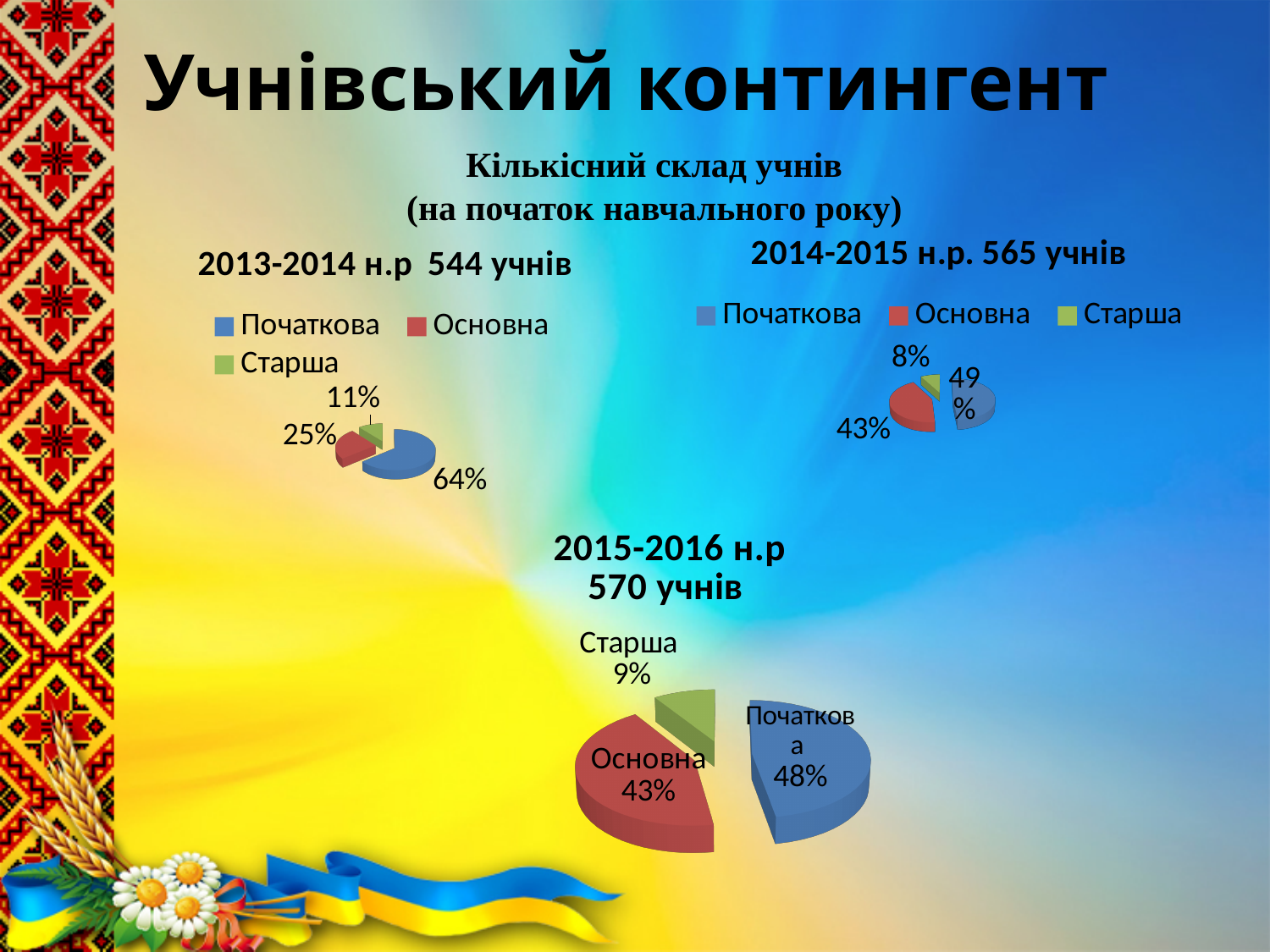
How many entries does the legend of the 2014-2015 н.р. chart list? 3 In the 2015-2016 н.р chart, what share does Основна have? 43% In the 2013-2014 н.р chart, which category has the smallest slice? Старша In the 2013-2014 н.р chart, what share does Початкова have? 64% In the 2013-2014 н.р chart, what is the difference between the Початкова and Основна shares? 39% In the 2015-2016 н.р chart, which category has the largest slice? Початкова What type of chart is used for the 2013-2014 н.р data? Pie chart How many charts are shown on the slide? 3 In the 2014-2015 н.р. chart, what share does Старша have? 8% In the 2013-2014 н.р chart, what share does Основна have? 25% In the 2014-2015 н.р. chart, which is larger, Початкова or Основна? Початкова How many slices does the 2015-2016 н.р chart have? 3